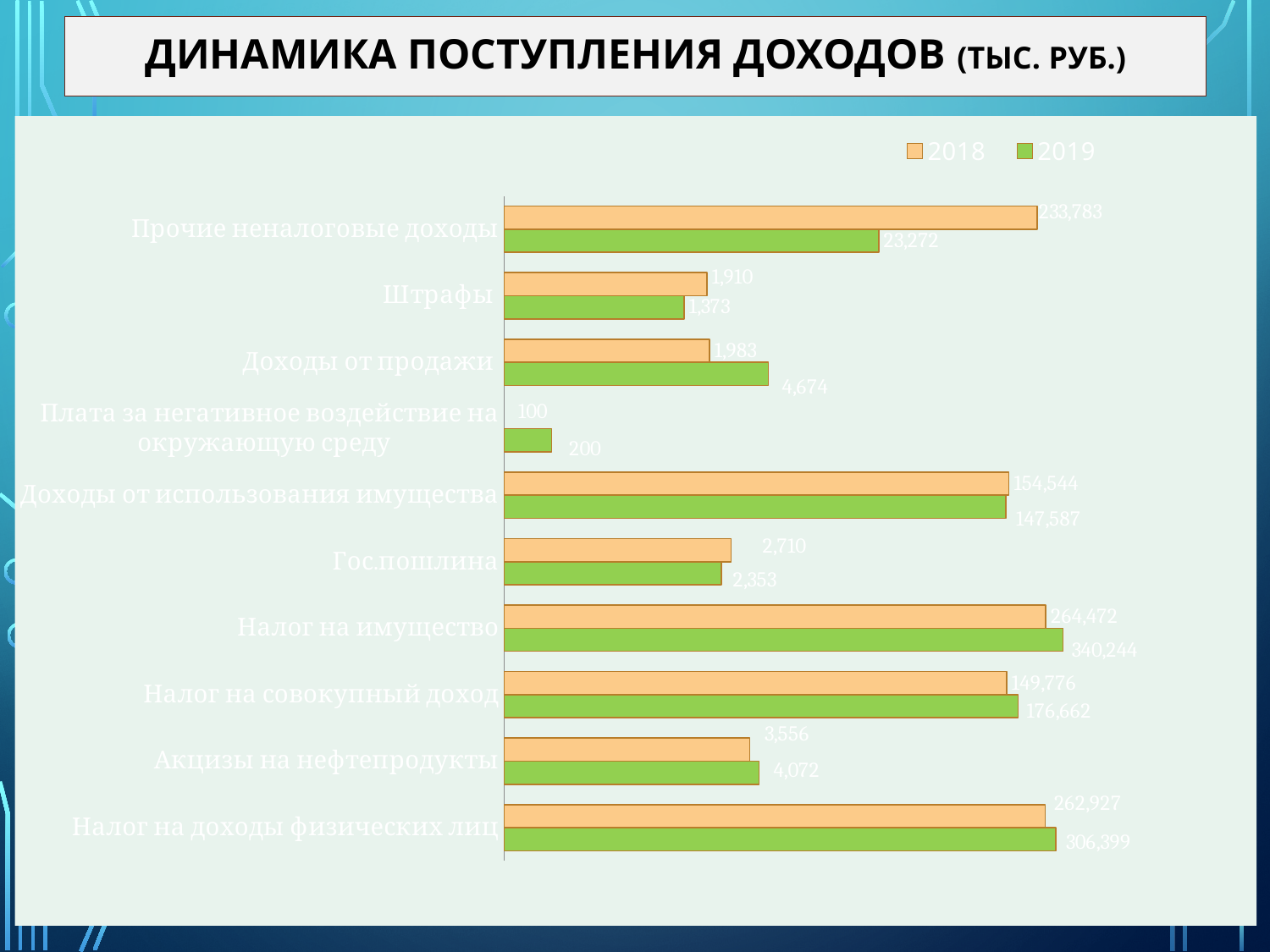
Which category has the lowest 2018 value? Плата за негативное воздействие на окружающую среду How many series does the legend list? 2 What is the 2018 value for Прочие неналоговые доходы? 233,783 What is the difference between the 2019 and 2018 values for Налог на имущество? 75,772 Which category has the highest 2019 value? Налог на имущество What is the difference between the 2019 and 2018 values for Налог на совокупный доход? 26,886 How many categories are shown on the chart? 10 What is the 2019 value for Налог на имущество? 340,244 What is the 2019 value for Налог на доходы физических лиц? 306,399 Which is larger for Доходы от продажи: the 2018 value or the 2019 value? 2019 What type of chart is shown on the slide? Bar chart What is the title of the chart? ДИНАМИКА ПОСТУПЛЕНИЯ ДОХОДОВ (ТЫС. РУБ.)